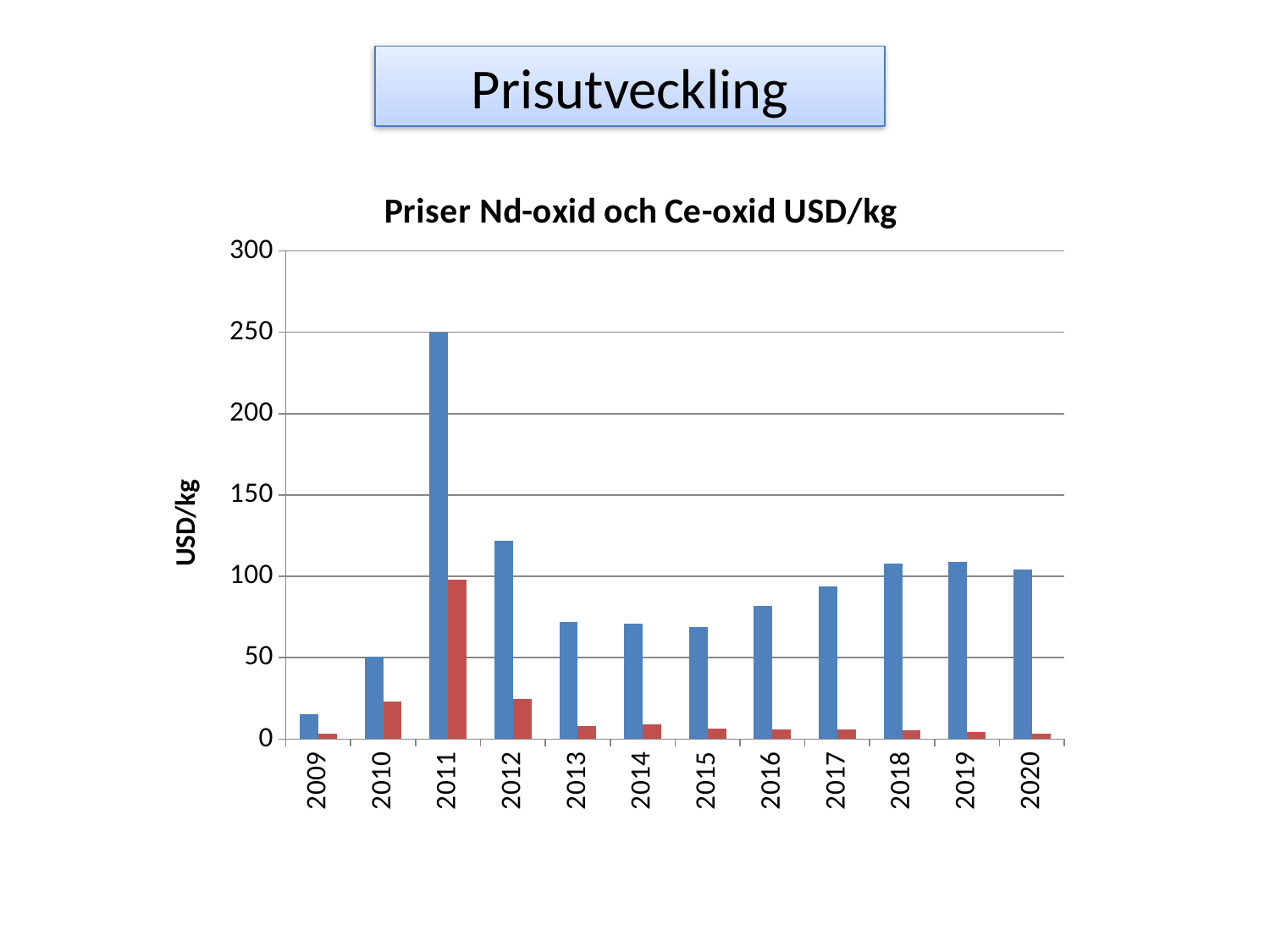
In which year is the red bar highest? 2011 What is the value of the blue bar for 2011? 250 What kind of chart is shown on the slide? bar chart Which is larger, the blue bar for 2019 or the blue bar for 2017? 2019 What is the title of the chart? Priser Nd-oxid och Ce-oxid USD/kg Is the value of the blue bar for 2015 greater or less than 100? less Is the value of the blue bar for 2012 greater or less than 100? greater What is the label on the vertical axis of the chart? USD/kg In which year is the blue bar highest? 2011 How many years are shown along the x axis of the chart? 12 In which year is the blue bar lowest? 2009